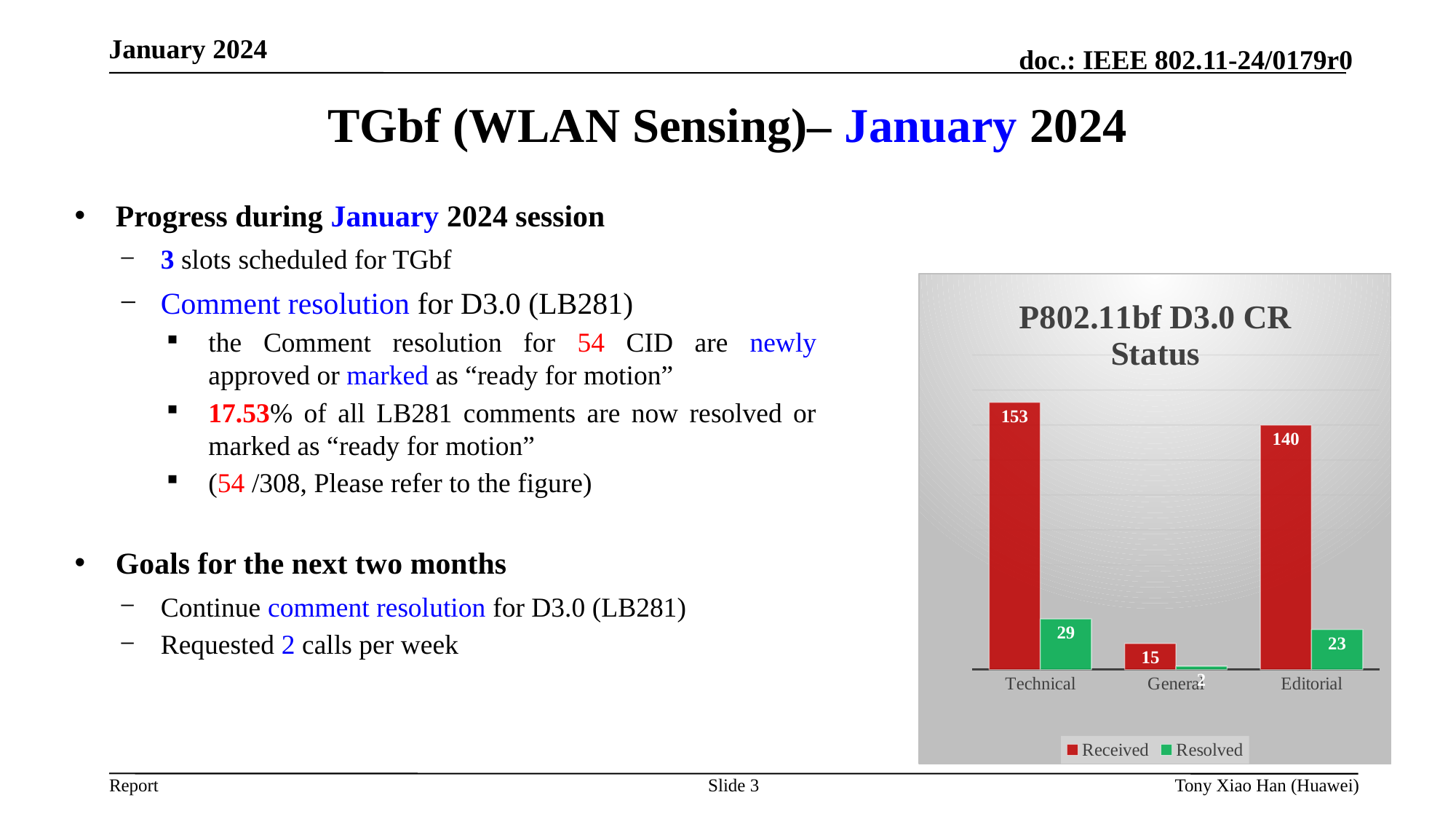
What type of chart is shown on the slide? bar chart What is the Received value for Technical? 153 What is the Resolved value for Editorial? 23 What is the Received value for General? 15 Which category has the highest Received value? Technical How many categories are shown on the x axis of the chart? 3 What is the difference between the Received values for Technical and Editorial? 13 How many series does the chart legend list? 2 Which is larger, the Resolved value for Technical or the Resolved value for Editorial? Technical What is the Resolved value for Technical? 29 What is the title of the chart? P802.11bf D3.0 CR Status Which category has the lowest Received value? General